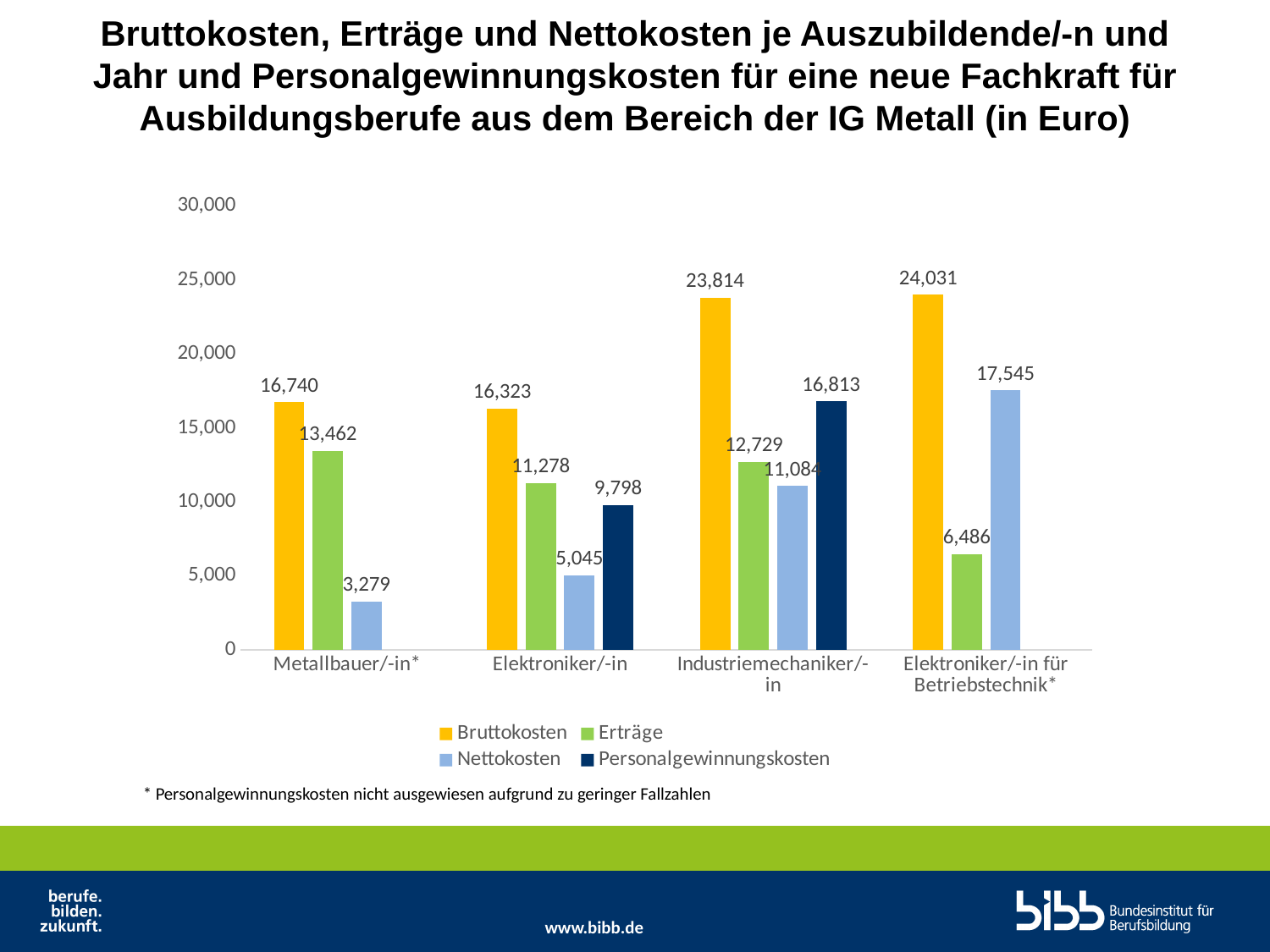
How many categories are shown on the x axis? 4 What is the Nettokosten value for Elektroniker/-in? 5,045 What kind of chart is shown on the slide? Bar chart What is the Personalgewinnungskosten value for Industriemechaniker/-in? 16,813 Which is larger for Elektroniker/-in: Erträge or Personalgewinnungskosten? Erträge Is the Nettokosten value for Elektroniker/-in für Betriebstechnik* greater or less than 15,000? greater What is the difference between Bruttokosten and Erträge for Industriemechaniker/-in? 11,085 How many series does the legend list? 4 What is the Erträge value for Elektroniker/-in für Betriebstechnik*? 6,486 What is the Bruttokosten value for Metallbauer/-in*? 16,740 Which category has the highest Bruttokosten? Elektroniker/-in für Betriebstechnik* Which category has the lowest Nettokosten? Metallbauer/-in*